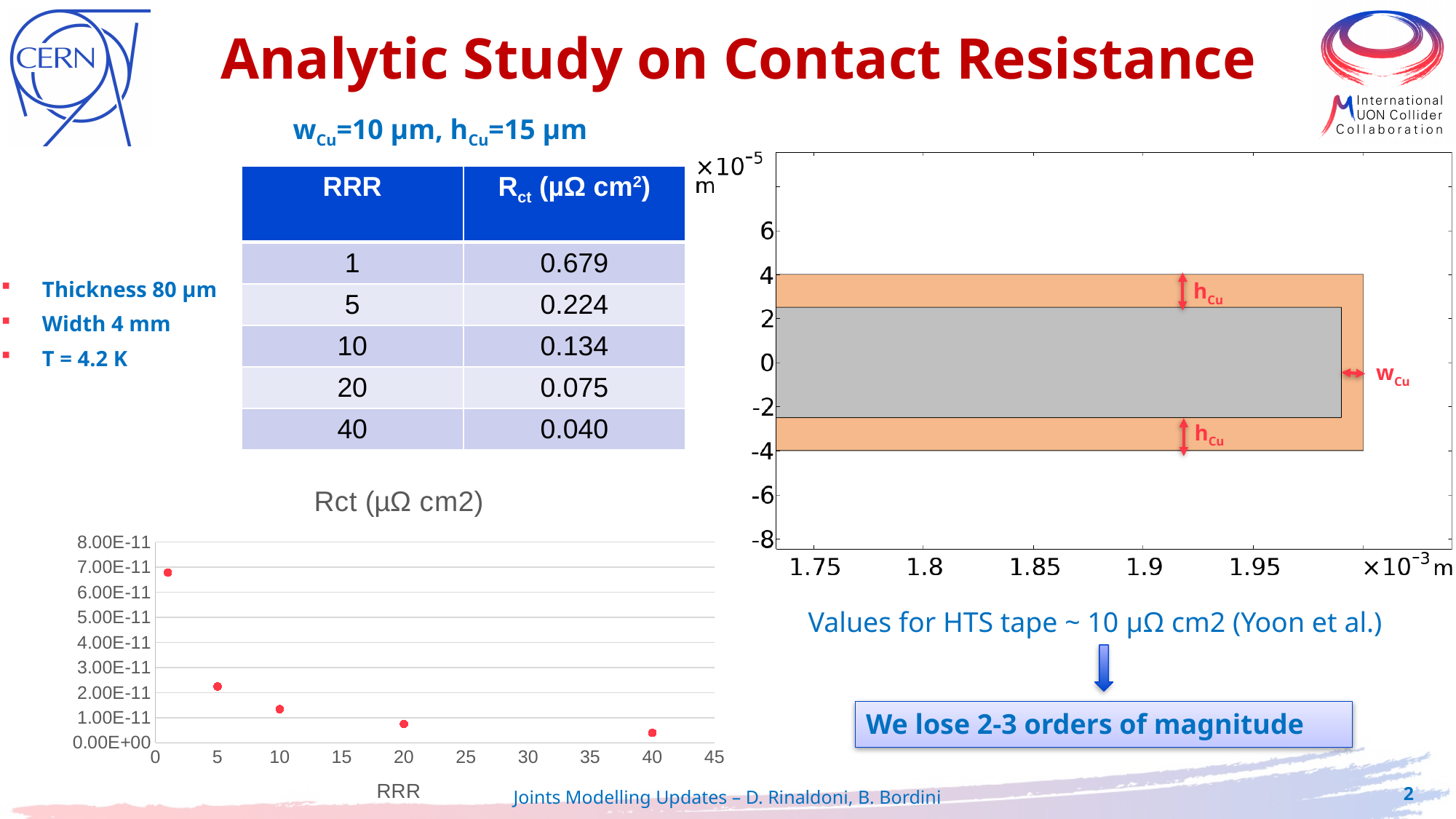
What is the title of the chart in the lower left of the slide? Rct (μΩ cm2) In the chart titled "Rct (μΩ cm2)", is the value at RRR = 5 greater or less than 3.00E-11? less In the chart titled "Rct (μΩ cm2)", is the value at RRR = 10 greater or less than 1.00E-11? greater How many data points are plotted in the chart titled "Rct (μΩ cm2)"? 5 In the chart titled "Rct (μΩ cm2)", at which RRR value is the plotted value highest? 1 In the chart titled "Rct (μΩ cm2)", is the value at RRR = 1 greater or less than 6.00E-11? greater In the chart titled "Rct (μΩ cm2)", which has the larger plotted value, RRR = 5 or RRR = 20? RRR = 5 In the chart titled "Rct (μΩ cm2)", at which RRR value is the plotted value lowest? 40 What kind of chart is the chart titled "Rct (μΩ cm2)"? scatter chart In the chart titled "Rct (μΩ cm2)", do the values rise or fall as RRR increases? fall What is the x-axis label of the chart titled "Rct (μΩ cm2)"? RRR